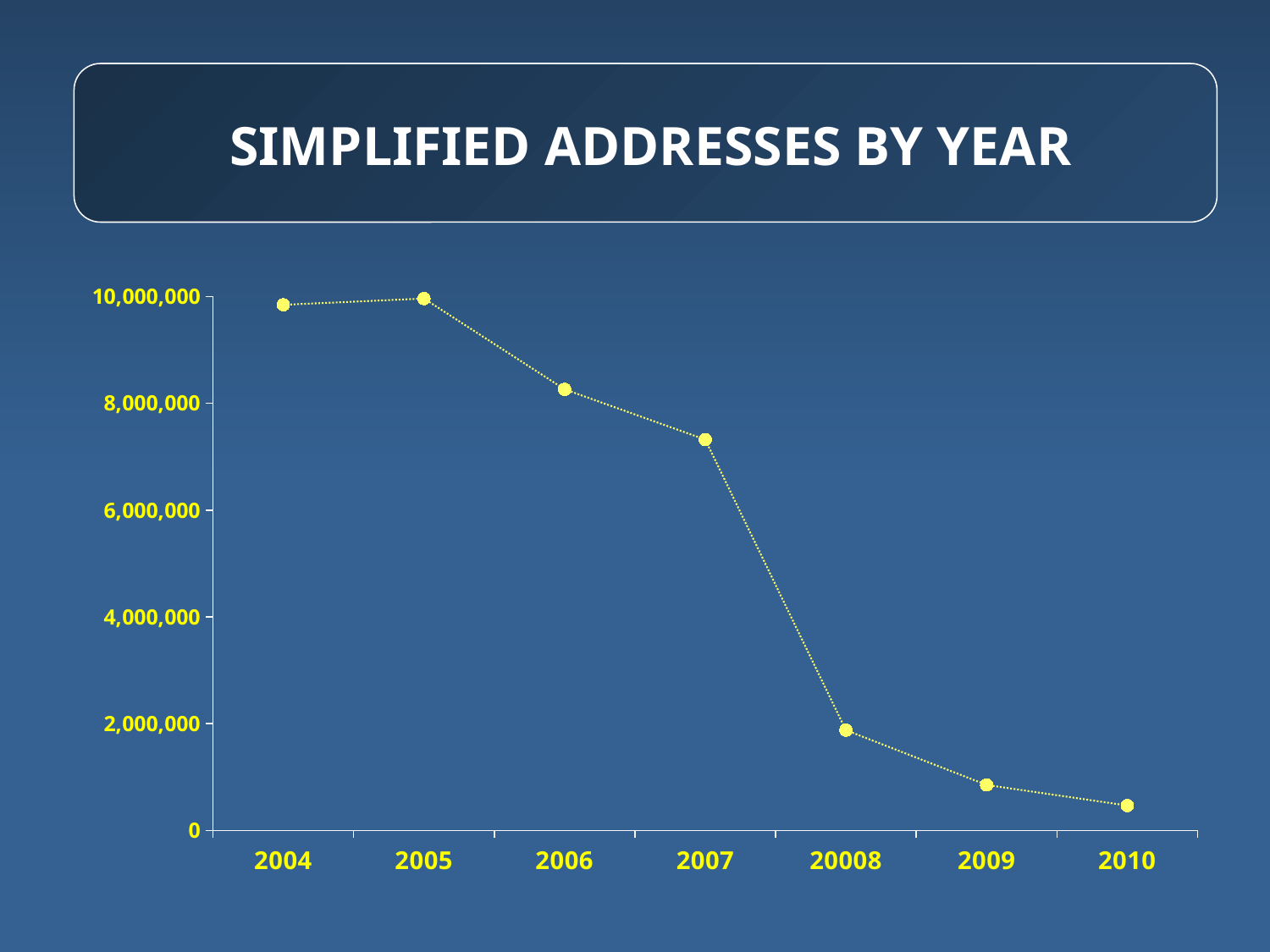
What kind of chart is shown on the slide? line chart Is the value for 2006 greater or less than 8,000,000? greater How many data points are plotted on the chart? 7 What is the title of the chart? SIMPLIFIED ADDRESSES BY YEAR Which is larger, the value for 2007 or the value for 2009? 2007 Is the value for 2009 greater or less than 2,000,000? less Is the value for 2007 greater or less than 6,000,000? greater Do the values generally rise or fall from 2004 to 2010? fall Which year has the lowest value on the chart? 2010 What is the highest value shown on the vertical axis? 10,000,000